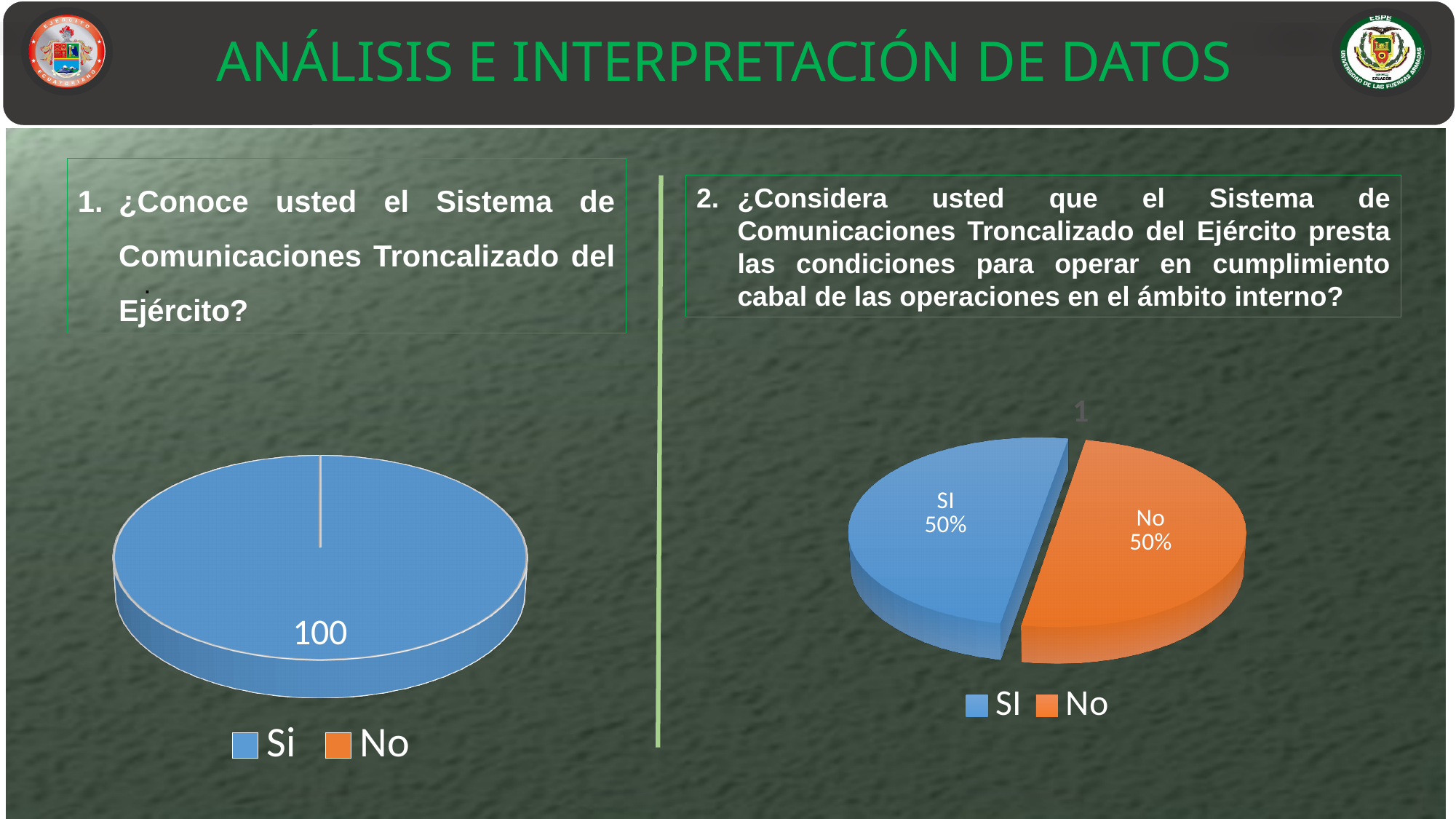
In the right pie chart (question 2), what is the share for No? 50% In the right pie chart (question 2), what is the difference between the SI share and the No share? 0% What type of chart is shown on the left side of the slide, under question 1? pie chart In the left pie chart (question 1), how many entries does the legend list? 2 In the right pie chart (question 2), how many slices does the pie have? 2 In the left pie chart (question 1), what value is printed on the pie? 100 In the right pie chart (question 2), what is the share for SI? 50% In the right pie chart (question 2), how many entries does the legend list? 2 In the left pie chart (question 1), which legend entry is shown in blue? Si In the right pie chart (question 2), which legend entry is shown in orange? No What type of chart is shown on the right side of the slide, under question 2? pie chart In the right pie chart (question 2), is the share for No greater or less than 25%? greater